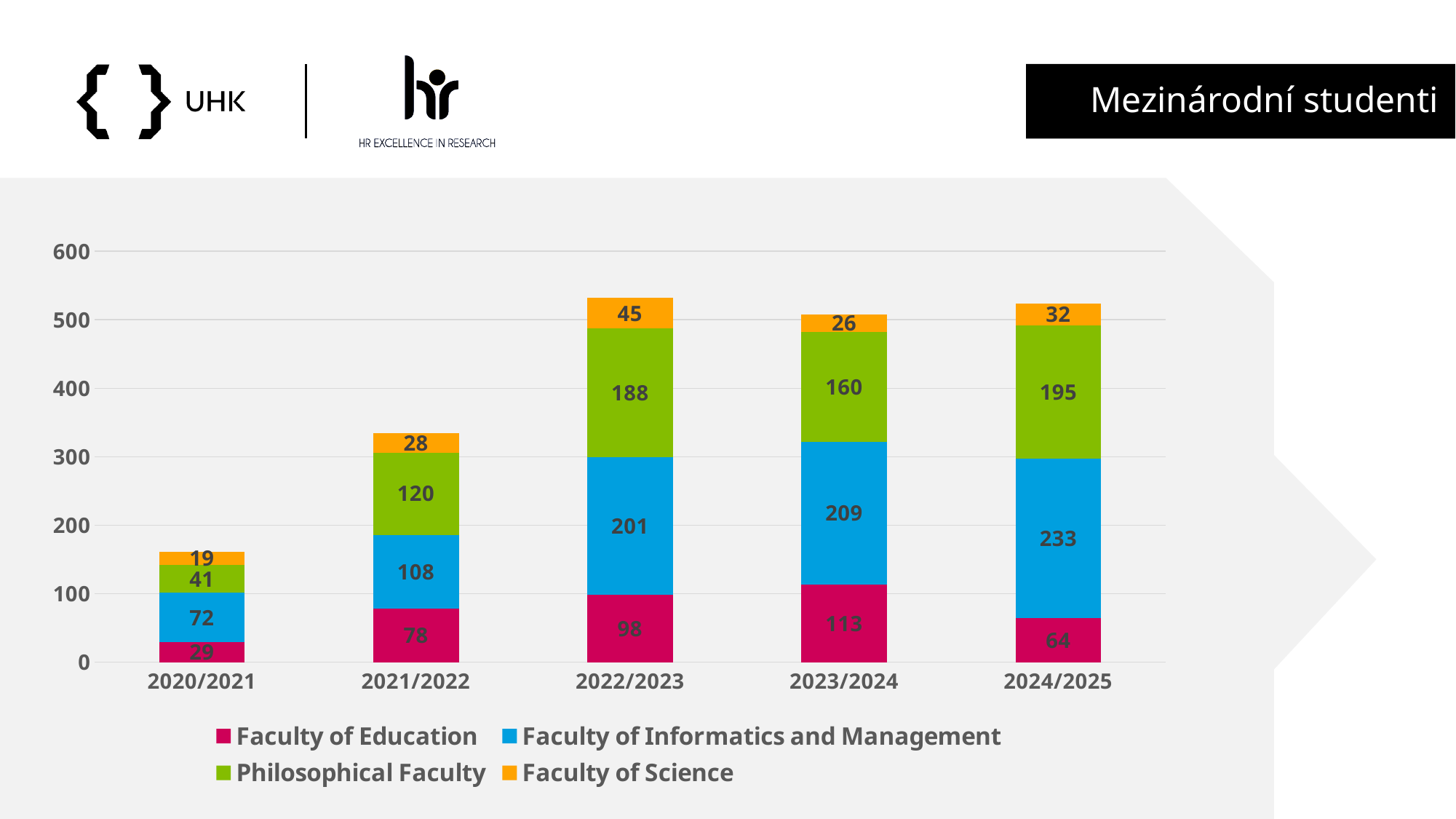
How many academic years are shown on the x axis? 5 What is the total of the stacked bar for 2020/2021? 161 What kind of chart is shown on the slide? Stacked bar chart What is the value for the Philosophical Faculty in 2021/2022? 120 What is the value for the Faculty of Science in 2022/2023? 45 What is the difference between the Philosophical Faculty values in 2024/2025 and 2023/2024? 35 Which is larger: the Faculty of Education value in 2022/2023 or in 2024/2025? 2022/2023 In which academic year is the Faculty of Science value lowest? 2020/2021 What is the total of the stacked bar for 2021/2022? 334 What is the value for the Faculty of Education in 2023/2024? 113 How many series does the legend list? 4 In which academic year is the Faculty of Informatics and Management value highest? 2024/2025